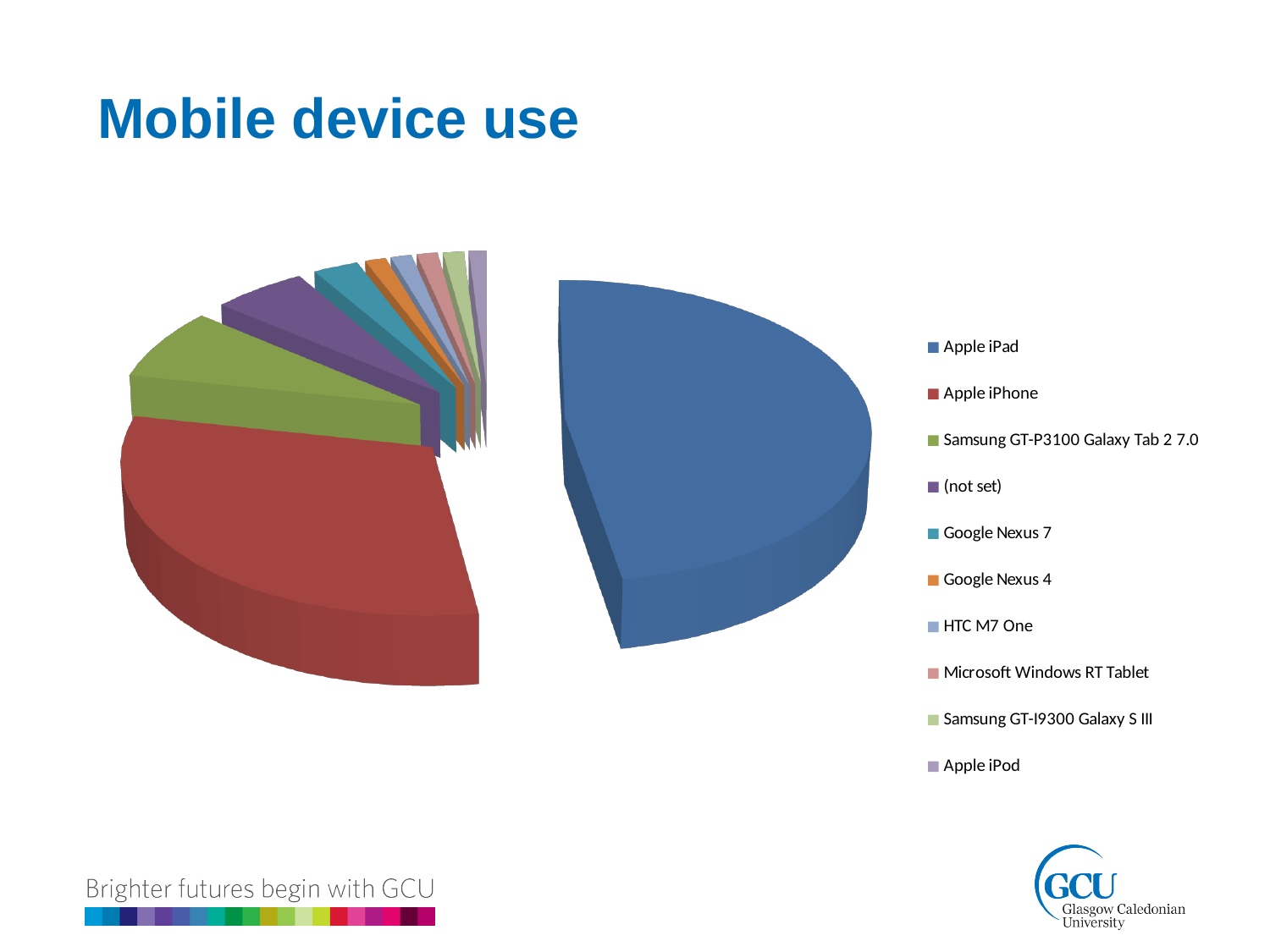
What kind of chart is shown on the slide? pie chart Which slice is larger, Samsung GT-P3100 Galaxy Tab 2 7.0 or (not set)? Samsung GT-P3100 Galaxy Tab 2 7.0 Which slice is larger, Apple iPhone or Samsung GT-P3100 Galaxy Tab 2 7.0? Apple iPhone What is the title of the slide containing the chart? Mobile device use How many categories does the legend list? 10 Which category has the largest slice of the pie? Apple iPad Which slice is larger, Apple iPhone or Google Nexus 7? Apple iPhone What colour is the Apple iPad slice in the pie chart? blue